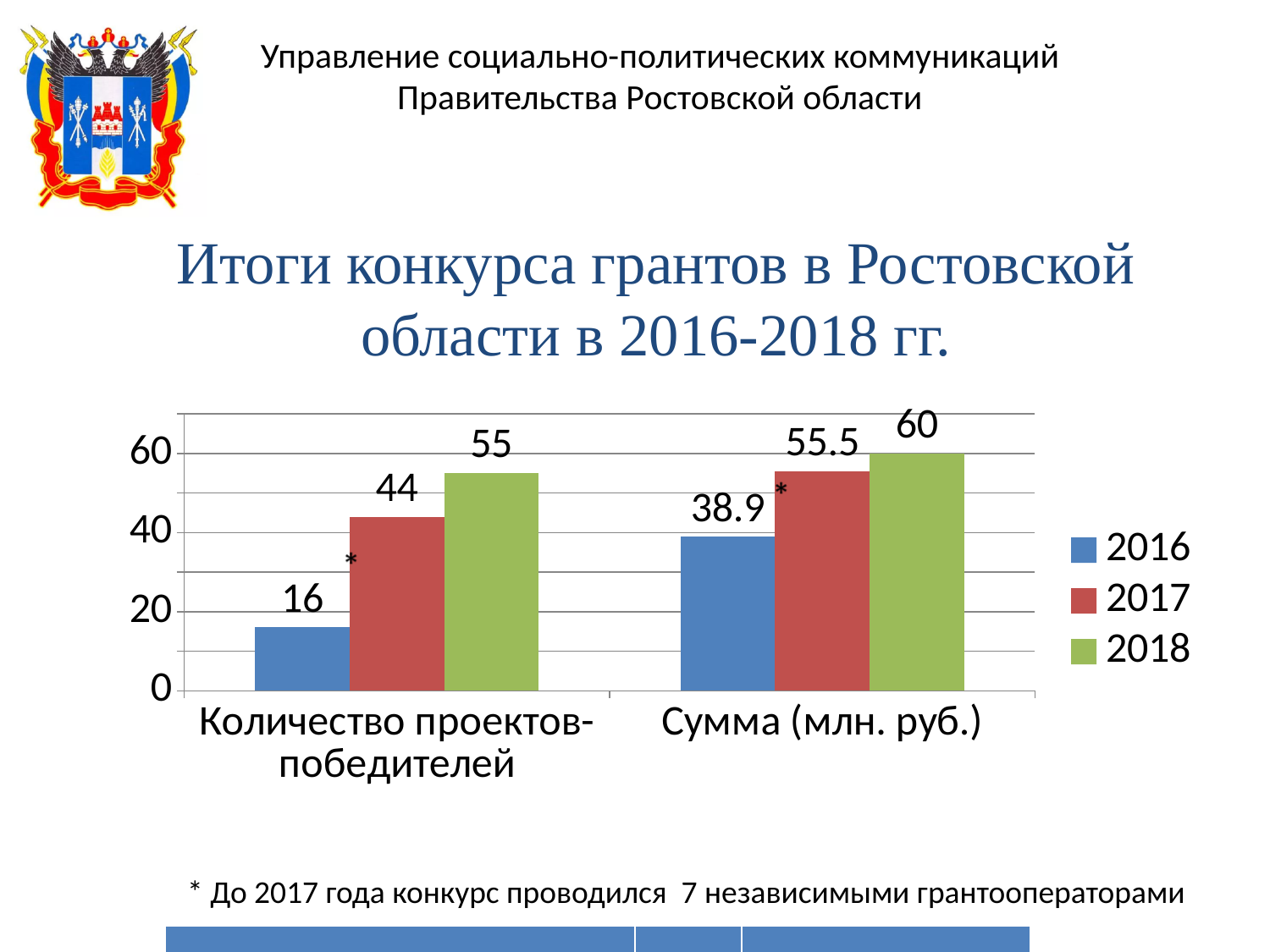
How many categories are shown on the x axis? 2 What is the value for 2016 in the 'Количество проектов-победителей' category? 16 Which year has the highest value in the 'Количество проектов-победителей' category? 2018 Which is larger: the 2017 value for 'Количество проектов-победителей' or the 2016 value for 'Сумма (млн. руб.)'? 2017 value for 'Количество проектов-победителей' What is the value for 2017 in the 'Сумма (млн. руб.)' category? 55.5 What is the difference between the 2018 and 2017 values in the 'Количество проектов-победителей' category? 11 What kind of chart is shown on the slide? Bar chart What is the value for 2018 in the 'Сумма (млн. руб.)' category? 60 Do the values for 'Сумма (млн. руб.)' rise or fall from 2016 to 2018? Rise How many series does the legend list? 3 Which year has the lowest value in the 'Сумма (млн. руб.)' category? 2016 What is the difference between the 2017 and 2016 values in the 'Сумма (млн. руб.)' category? 16.6